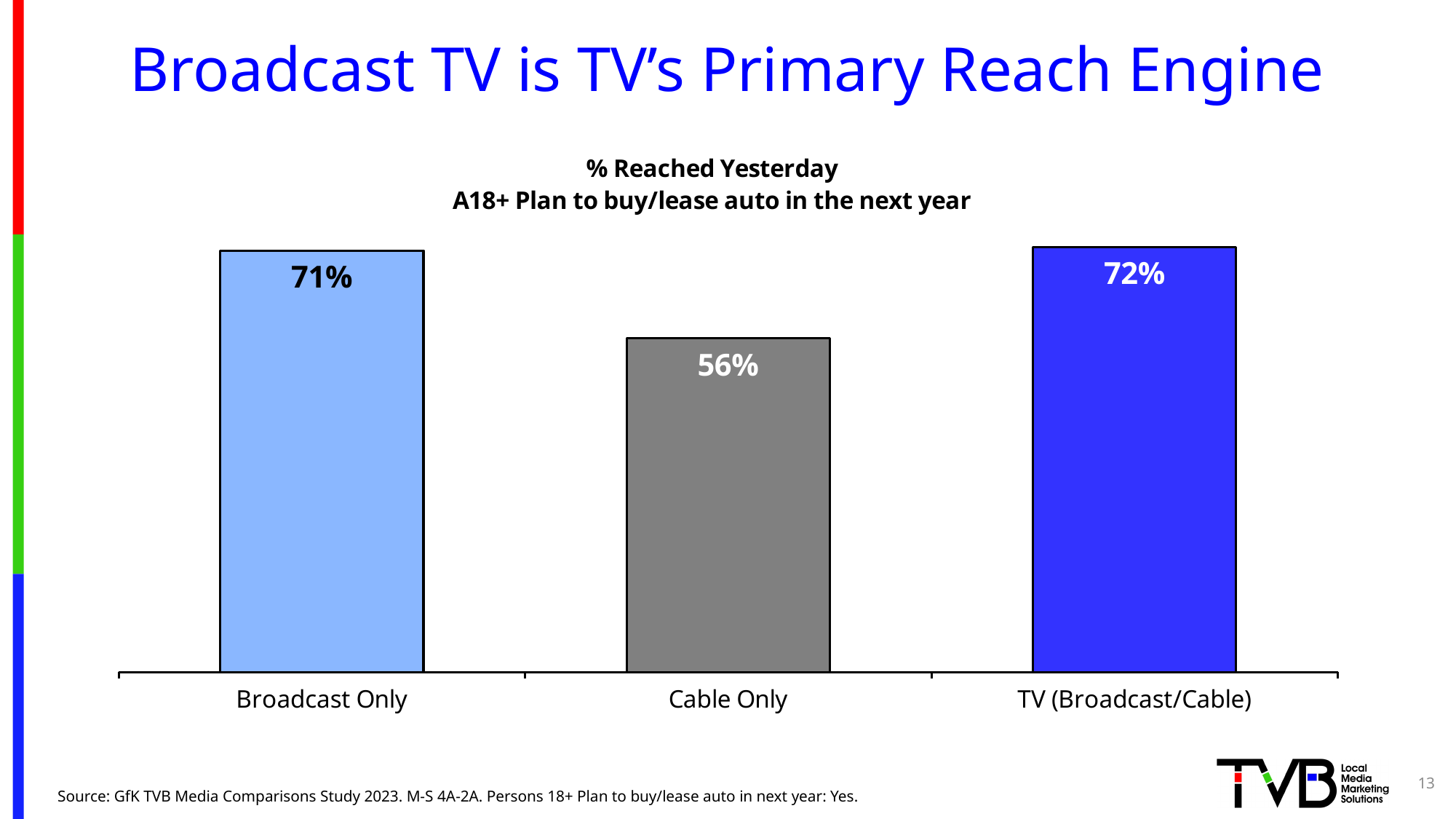
What is the value for Broadcast Only? 71% What is the difference between the values for TV (Broadcast/Cable) and Cable Only? 16% What is the title of the chart? % Reached Yesterday A18+ Plan to buy/lease auto in the next year What is the value for TV (Broadcast/Cable)? 72% Which category has the lowest value? Cable Only Which is larger, the value for Broadcast Only or the value for Cable Only? Broadcast Only What is the difference between the values for Broadcast Only and Cable Only? 15% What is the value for Cable Only? 56% What colour is the bar for Cable Only? Grey Which category has the highest value? TV (Broadcast/Cable) How many categories are shown in the chart? 3 What kind of chart is shown on the slide? Bar chart